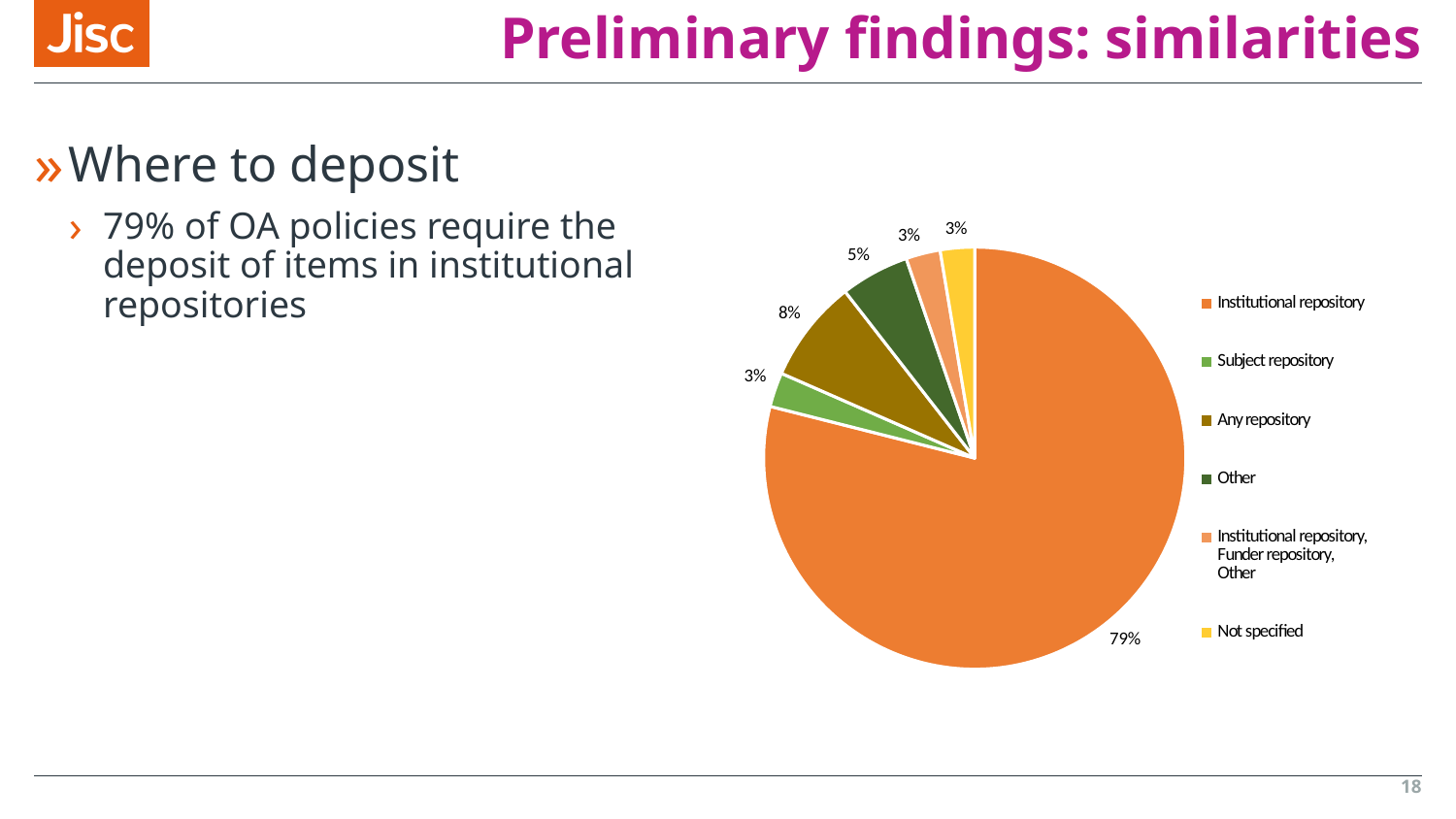
What share of the pie does Any repository have? 8% What share of the pie does Institutional repository have? 79% Which is larger, the share for Any repository or the share for Other? Any repository How many categories does the legend list? 6 What is the difference between the shares for Institutional repository and Any repository? 71% What is the difference between the shares for Any repository and Other? 3% What share of the pie does Other have? 5% What colour is the slice for Institutional repository? orange Which category has the largest slice of the pie? Institutional repository What share of the pie does Not specified have? 3% What share of the pie does Subject repository have? 3% What kind of chart is shown on the slide? pie chart